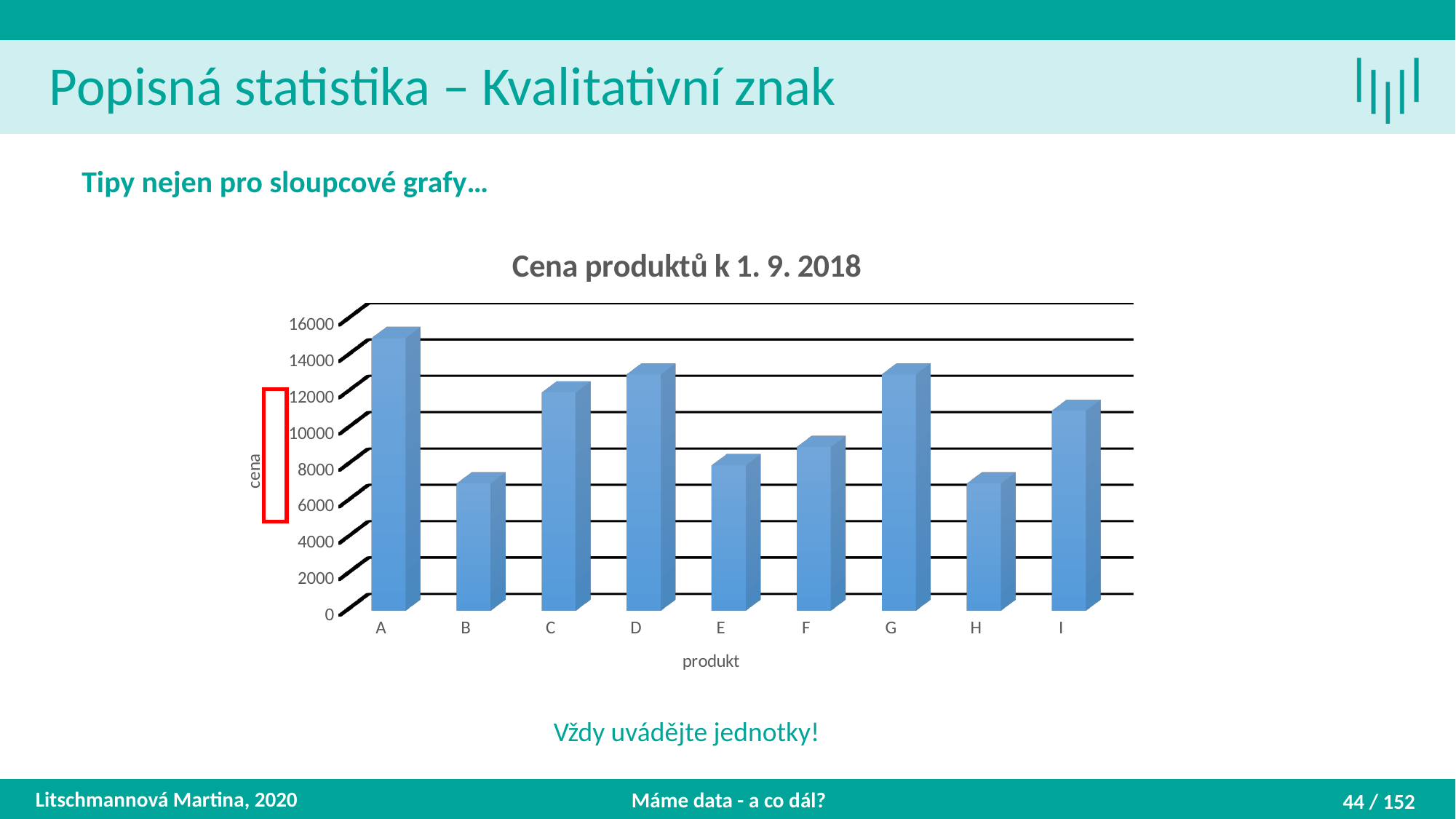
Is the value for product A greater or less than 14000? greater How many products are shown on the x axis of the chart? 9 Which has a higher value, product G or product H? G Is the value for product B greater or less than 8000? less Is the value for product D greater or less than 12000? greater Which product has the highest price in the chart? A Which has a higher value, product C or product E? C What is the title of the chart? Cena produktů k 1. 9. 2018 What is the label of the horizontal axis of the chart? produkt What kind of chart is shown on the slide? bar chart